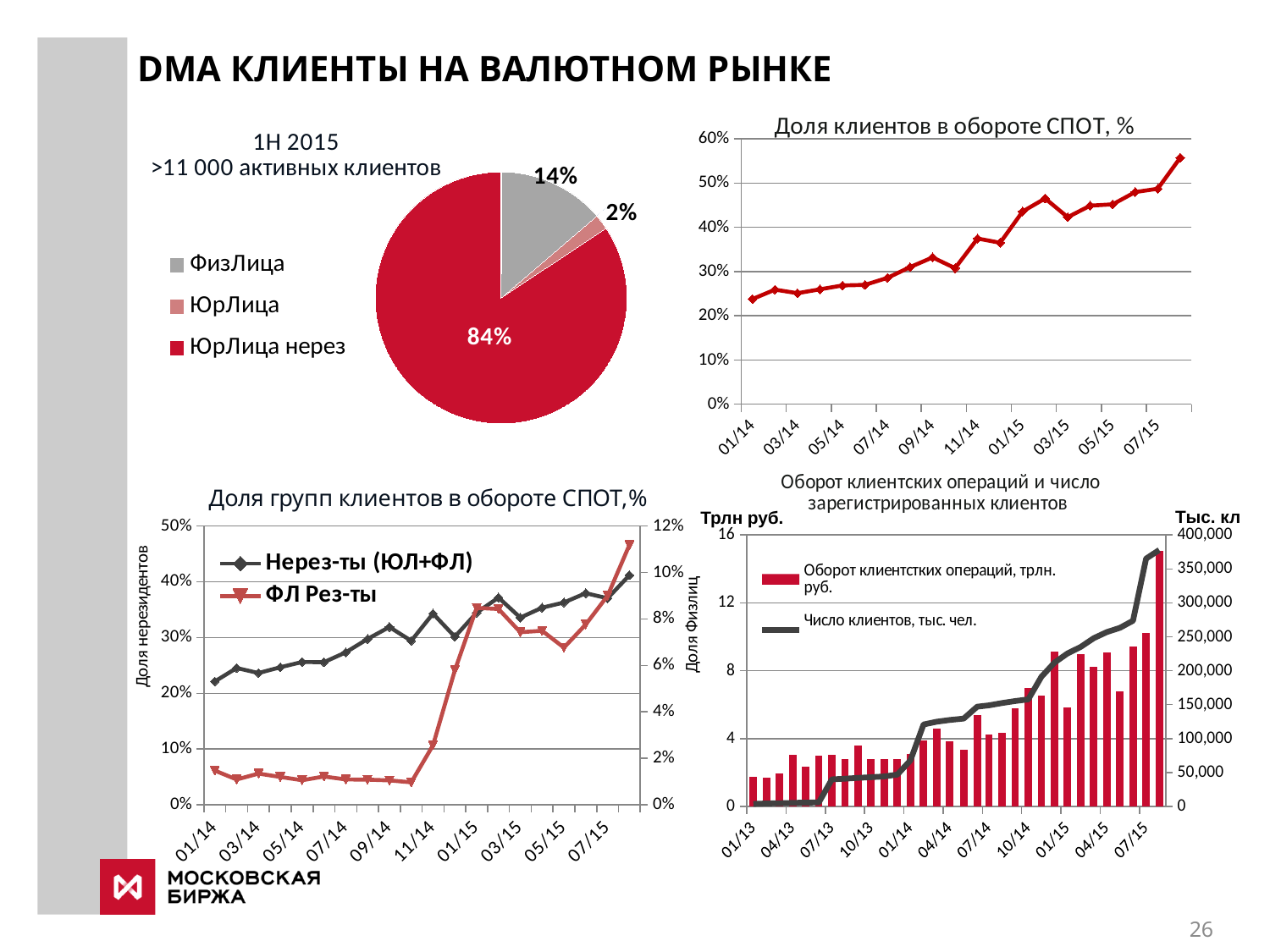
In the pie chart on the top left, how many percentage points larger is the ЮрЛица нерез slice than the ФизЛица slice? 70 How many series does the legend of the chart 'Доля групп клиентов в обороте СПОТ,%' list? 2 In the chart 'Доля клиентов в обороте СПОТ, %', is the last value (after 07/15) greater or less than 50%? greater In the pie chart on the top left, which category has the largest slice? ЮрЛица нерез In the chart 'Доля групп клиентов в обороте СПОТ,%', is the value for Нерез-ты (ЮЛ+ФЛ) at 01/14 greater or less than 30%? less What kind of chart is 'Доля клиентов в обороте СПОТ, %' on the top right? line chart In the pie chart on the top left, what share is shown for ЮрЛица нерез? 84% In the bottom-right chart 'Оборот клиентских операций и число зарегистрированных клиентов', is the turnover bar at 07/15 greater or less than 12 trln rub.? less In the pie chart on the top left, which category has the smallest slice? ЮрЛица In the chart 'Доля клиентов в обороте СПОТ, %', do the values generally rise or fall from 01/14 to 07/15? rise In the pie chart on the top left, what share is shown for ФизЛица? 14% How many categories does the pie chart on the top left show? 3